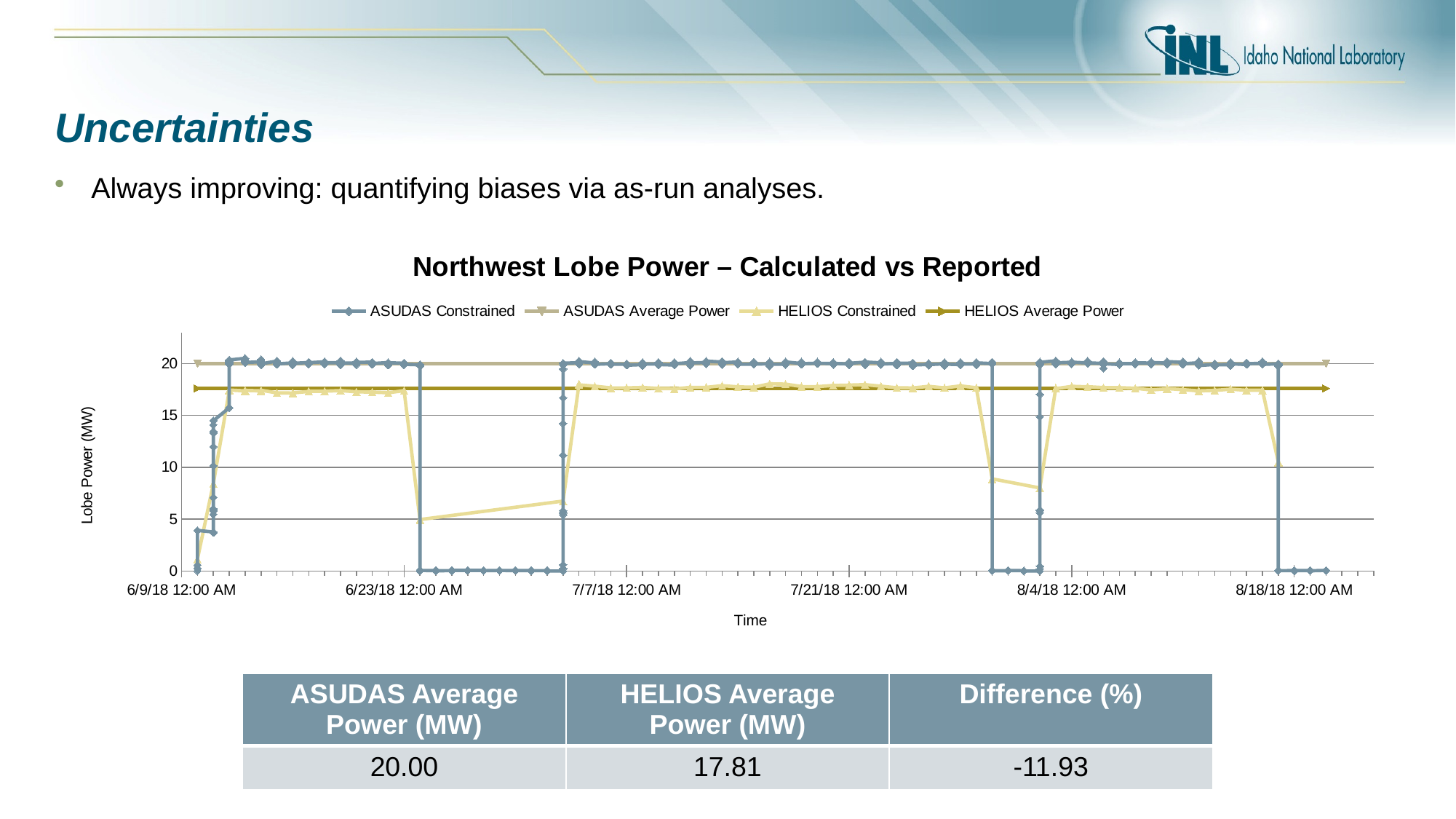
How many series does the chart legend list? 4 Is the value of HELIOS Constrained at 7/7/18 12:00 AM greater or less than 10? greater What kind of chart is shown on the slide? line chart What is the label of the vertical axis of the chart? Lobe Power (MW) Is the value of ASUDAS Constrained at 6/9/18 12:00 AM greater or less than 5? less What is the title of the chart? Northwest Lobe Power – Calculated vs Reported According to the table below the chart, what is the HELIOS Average Power in MW? 17.81 What value does the ASUDAS Average Power line sit at on the chart? 20 Which is higher on the chart, the ASUDAS Average Power line or the HELIOS Average Power line? ASUDAS Average Power Is the value of HELIOS Constrained at 7/21/18 12:00 AM greater or less than 20? less